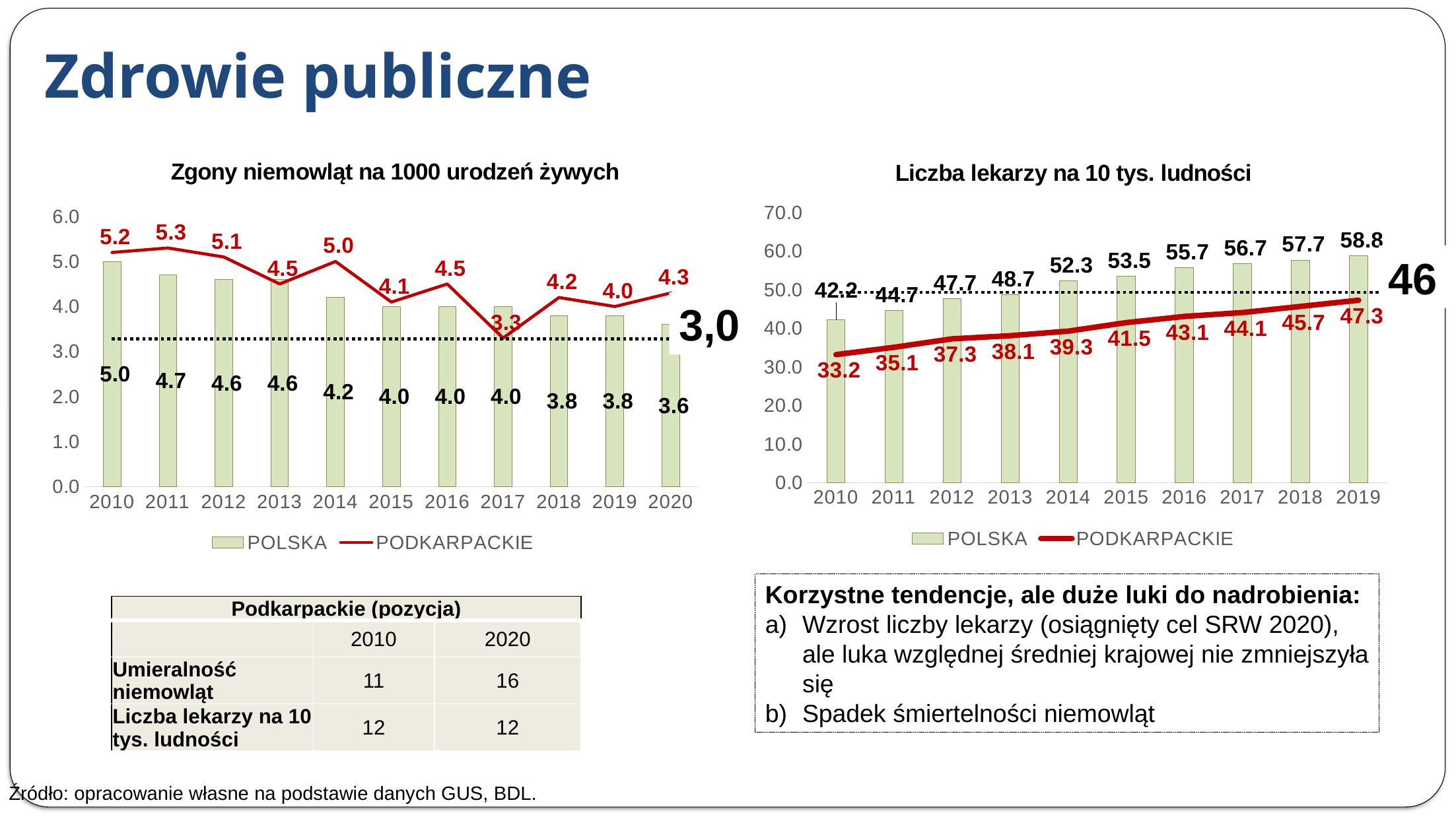
In the chart 'Zgony niemowląt na 1000 urodzeń żywych', do the POLSKA values rise or fall from 2010 to 2020? fall In the chart 'Liczba lekarzy na 10 tys. ludności', what is the value for PODKARPACKIE in 2019? 47.3 In the chart 'Zgony niemowląt na 1000 urodzeń żywych', what is the value for PODKARPACKIE in 2017? 3.3 In the chart 'Liczba lekarzy na 10 tys. ludności', what is the value for POLSKA in 2014? 52.3 In the chart 'Zgony niemowląt na 1000 urodzeń żywych', how many years are shown on the x axis? 11 In the chart 'Zgony niemowląt na 1000 urodzeń żywych', what is the value for POLSKA in 2010? 5.0 In the chart 'Zgony niemowląt na 1000 urodzeń żywych', what is the difference between the PODKARPACKIE and POLSKA values in 2020? 0.7 In the chart 'Liczba lekarzy na 10 tys. ludności', which is larger in 2016: POLSKA or PODKARPACKIE? POLSKA In the chart 'Zgony niemowląt na 1000 urodzeń żywych', in which year is the PODKARPACKIE value highest? 2011 How many series does the legend of the chart 'Liczba lekarzy na 10 tys. ludności' list? 2 In the chart 'Liczba lekarzy na 10 tys. ludności', what is the difference between the POLSKA and PODKARPACKIE values in 2010? 9.0 In the chart 'Liczba lekarzy na 10 tys. ludności', in which year is the POLSKA value lowest? 2010